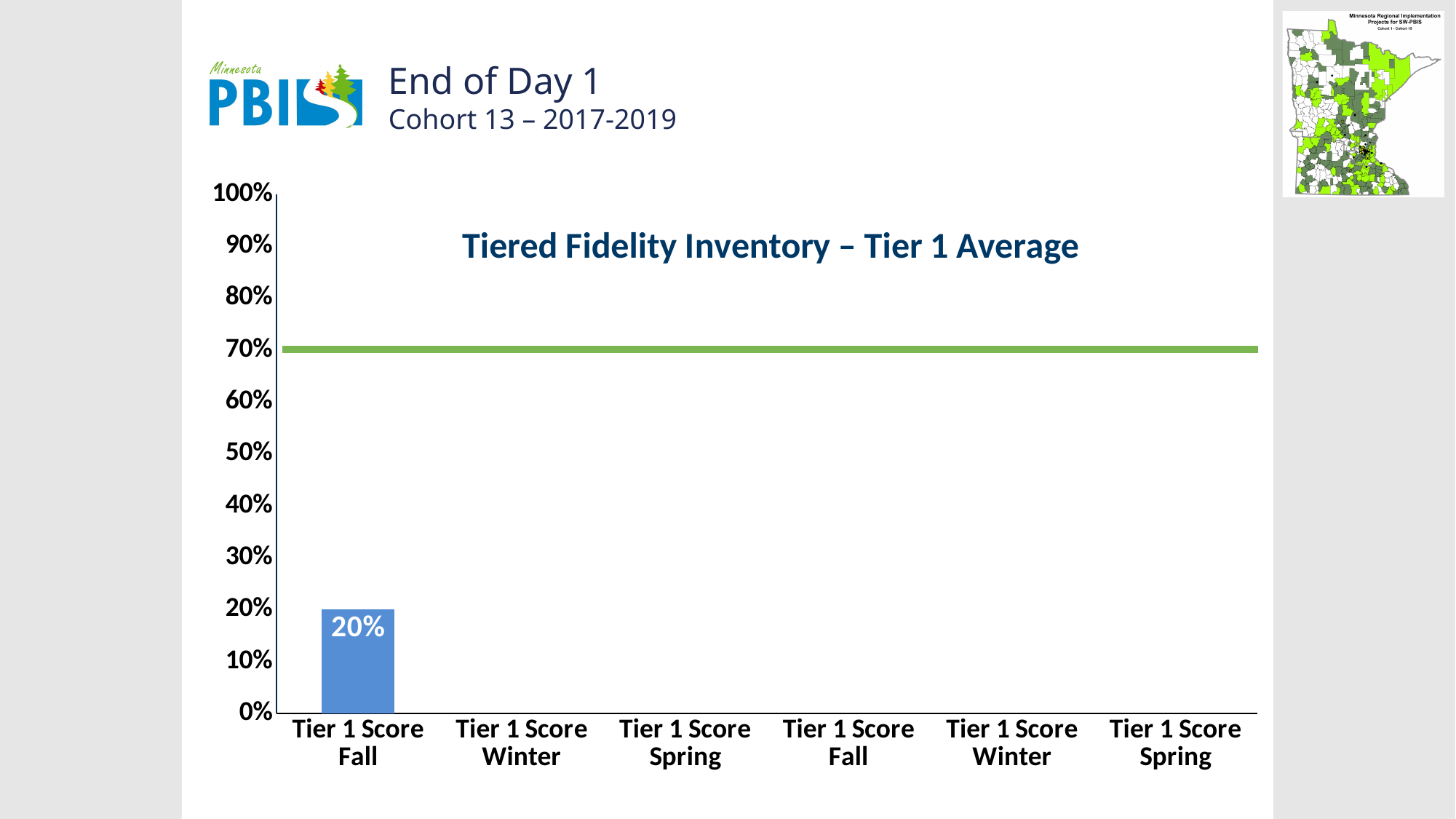
What is the title of the chart? Tiered Fidelity Inventory – Tier 1 Average What is the value shown for the first Tier 1 Score Fall bar? 20% What kind of chart is shown on the slide? bar chart How many categories are listed along the x axis of the chart? 6 What colour is the plotted bar in the chart? blue Which category has a plotted value in the chart? Tier 1 Score Fall (first) Is the value for the first Tier 1 Score Fall bar greater or less than 30%? less Is the first Tier 1 Score Fall bar above or below the green horizontal line? below What is the difference between the green line level and the first Tier 1 Score Fall bar value? 50 percentage points At what level on the y axis is the green horizontal line drawn? 70% How many bars are actually plotted in the chart? 1 What is the highest value shown on the y axis? 100%